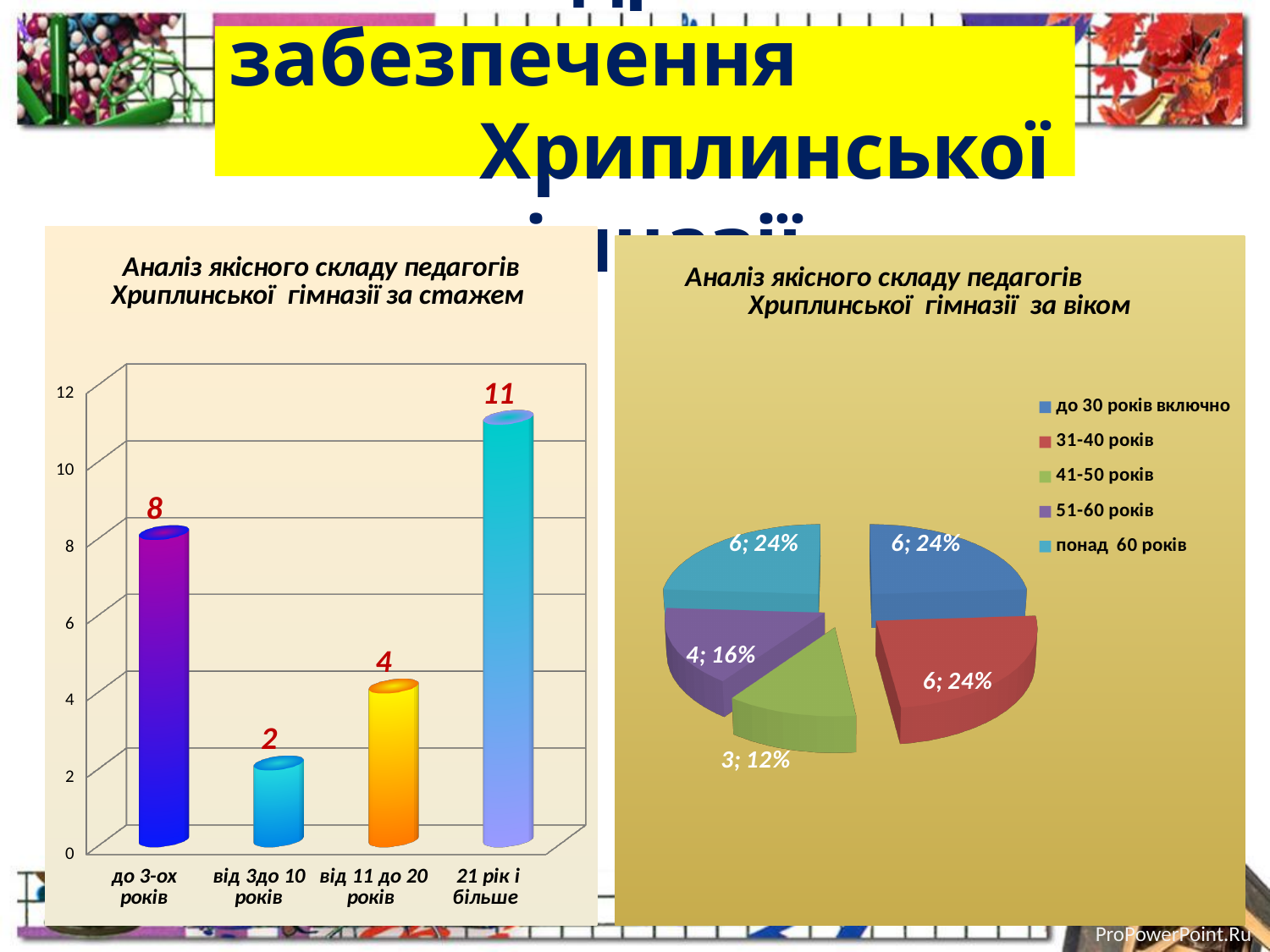
In the bar chart on the left (за стажем), which is larger: the value for "від 11 до 20 років" or "від 3 до 10 років"? від 11 до 20 років In the bar chart on the left (за стажем), what is the value for "21 рік і більше"? 11 In the bar chart on the left (за стажем), what is the difference between the values for "21 рік і більше" and "до 3-ох років"? 3 In the pie chart on the right (за віком), what share does the "41-50 років" slice have? 12% How many categories are shown in the bar chart on the left (за стажем)? 4 How many entries does the legend of the pie chart on the right (за віком) list? 5 In the bar chart on the left (за стажем), which category has the lowest value? від 3 до 10 років In the bar chart on the left (за стажем), which category has the highest value? 21 рік і більше In the bar chart on the left (за стажем), what is the value for "до 3-ох років"? 8 In the pie chart on the right (за віком), what is the value for "51-60 років"? 4 What type of chart is the chart on the right (за віком)? pie chart What type of chart is the chart on the left (за стажем)? bar chart